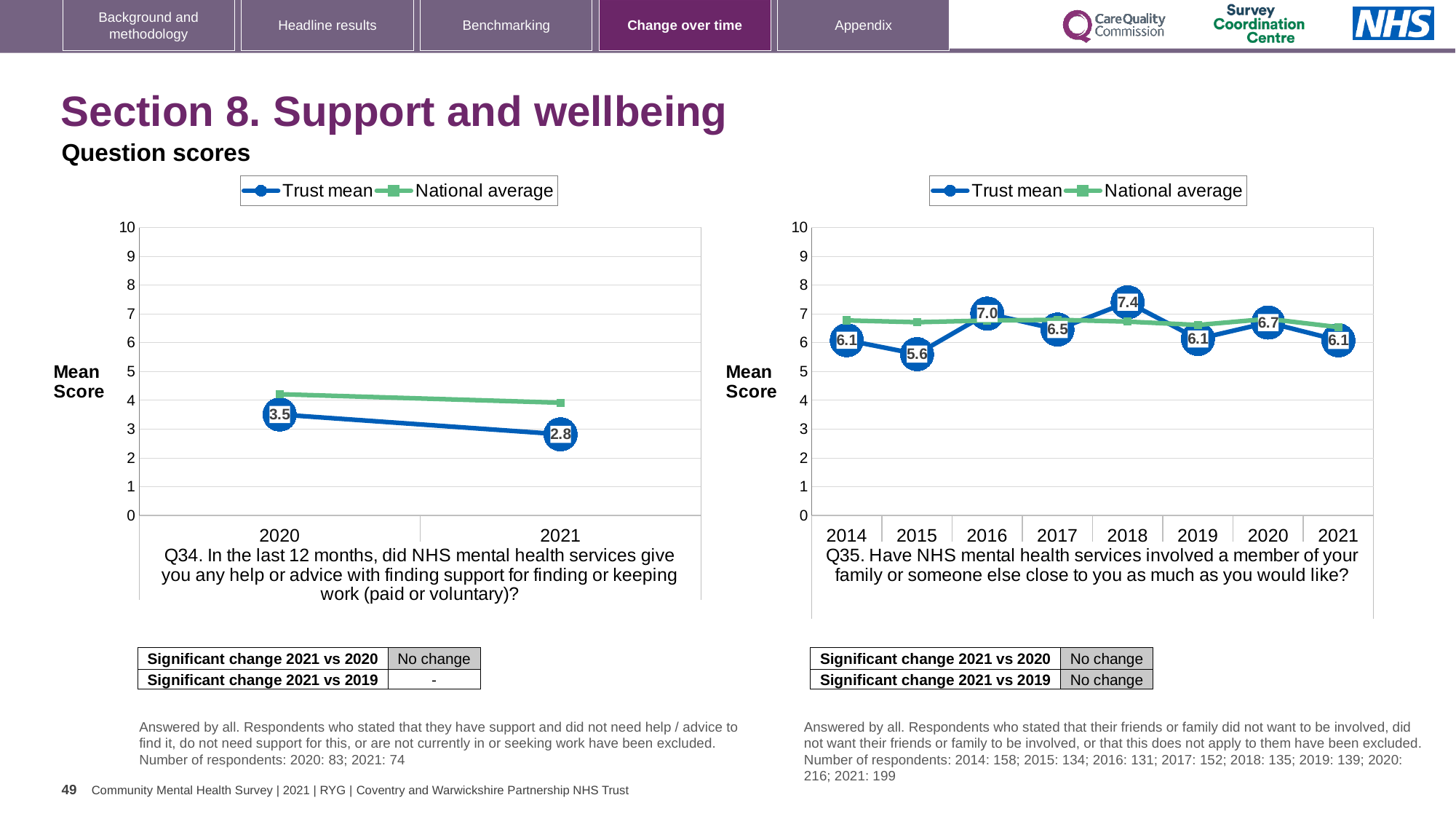
How many series does the legend of the Q35 chart on the right list? 2 In the Q35 chart on the right, is the Trust mean higher in 2016 or in 2017? 2016 In the Q34 chart on the left, by how much did the Trust mean fall from 2020 to 2021? 0.7 How many years are plotted on the x axis of the Q35 chart on the right? 8 In the Q35 chart on the right, what is the Trust mean for 2018? 7.4 In the Q34 chart on the left, what is the Trust mean for 2020? 3.5 In the Q34 chart on the left, is the National average for 2020 greater or less than 4? greater In the Q34 chart on the left, does the Trust mean rise or fall from 2020 to 2021? fall In the Q35 chart on the right, what is the difference between the Trust mean in 2018 and in 2015? 1.8 In the Q35 chart on the right, which year has the highest Trust mean? 2018 In the Q34 chart on the left, what is the Trust mean for 2021? 2.8 In the Q35 chart on the right, which year has the lowest Trust mean? 2015